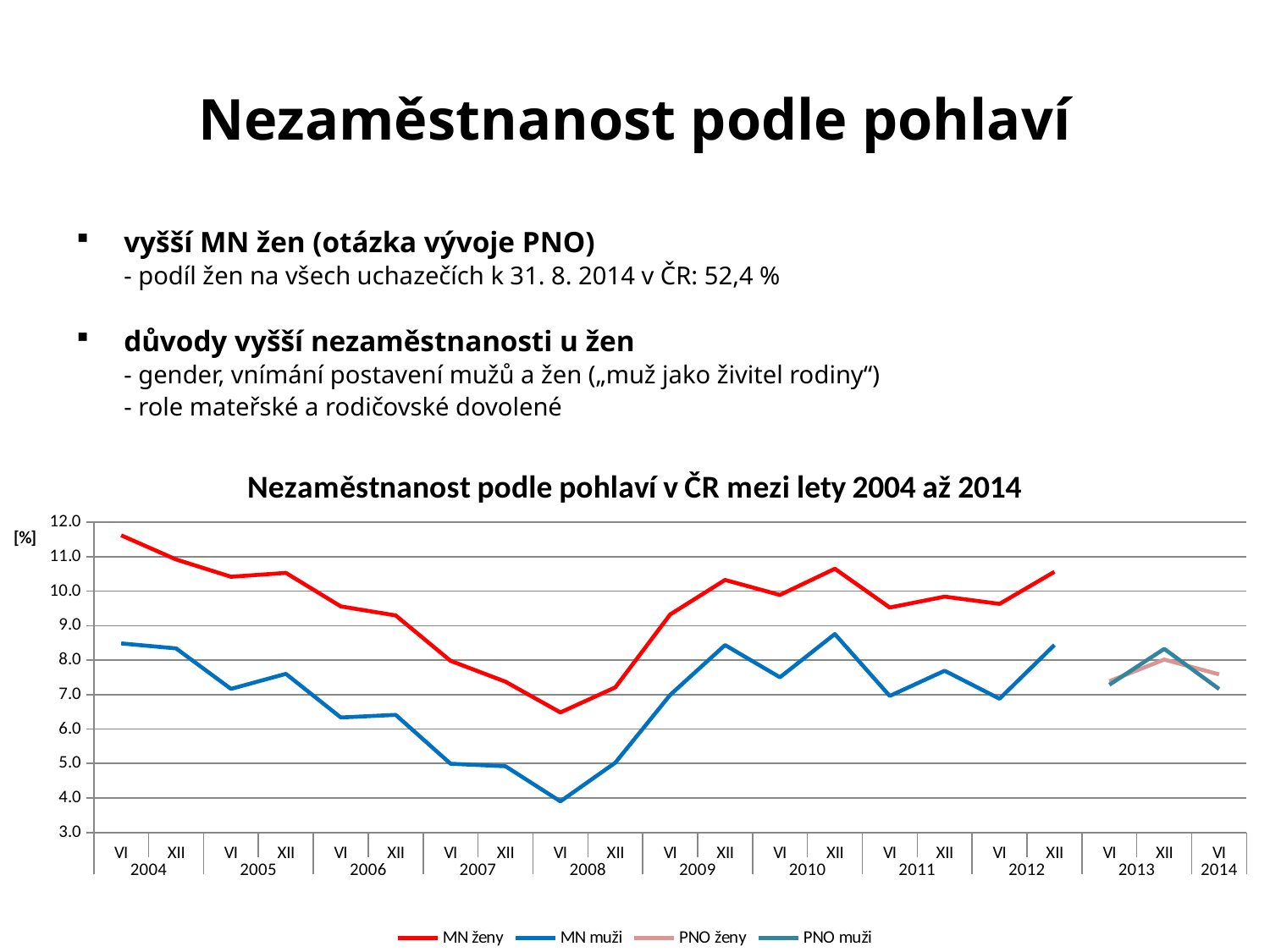
At which point on the x axis does the MN ženy series reach its lowest value? VI 2008 Does the MN ženy series rise or fall between VI 2004 and VI 2008? fall Is the value for MN ženy at VI 2004 greater or less than 11.0? greater What kind of chart is shown on the slide? line chart Is the value for MN muži at VI 2008 greater or less than 5.0? less Which series has the highest value at VI 2004, MN ženy or MN muži? MN ženy How many series does the chart legend list? 4 How many years are labelled along the x axis of the chart? 11 What unit is shown on the vertical axis of the chart? [%] At which point on the x axis does the MN muži series reach its lowest value? VI 2008 At which point on the x axis does the MN ženy series reach its highest value? VI 2004 What is the title of the chart? Nezaměstnanost podle pohlaví v ČR mezi lety 2004 až 2014